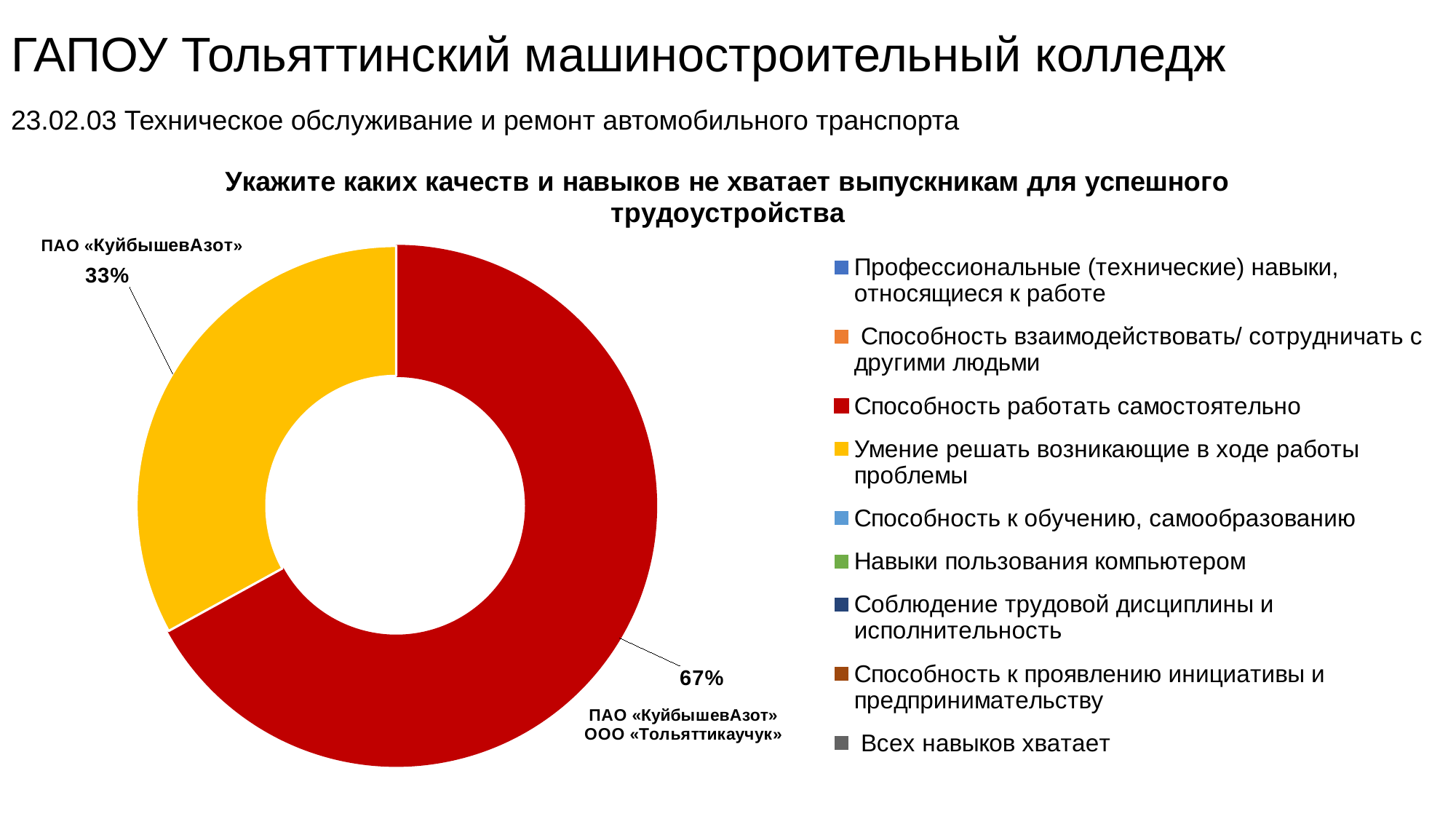
Is the share for Способность работать самостоятельно larger or smaller than the share for Умение решать возникающие в ходе работы проблемы? larger What share of the chart does the red slice (Способность работать самостоятельно) represent? 67% Which of the two visible slices is smaller? Умение решать возникающие в ходе работы проблемы Which category has the largest slice in the chart? Способность работать самостоятельно What is the difference in percentage points between the red slice and the yellow slice? 34 How many entries does the legend list? 9 What share of the chart does the yellow slice (Умение решать возникающие в ходе работы проблемы) represent? 33% What is the total of the two labelled slices? 100% How many slices are visible in the doughnut chart? 2 Which employer label is attached to the 33% slice? ПАО «КуйбышевАзот» What is the title of the chart? Укажите каких качеств и навыков не хватает выпускникам для успешного трудоустройства What kind of chart is shown on the slide? Doughnut (pie) chart